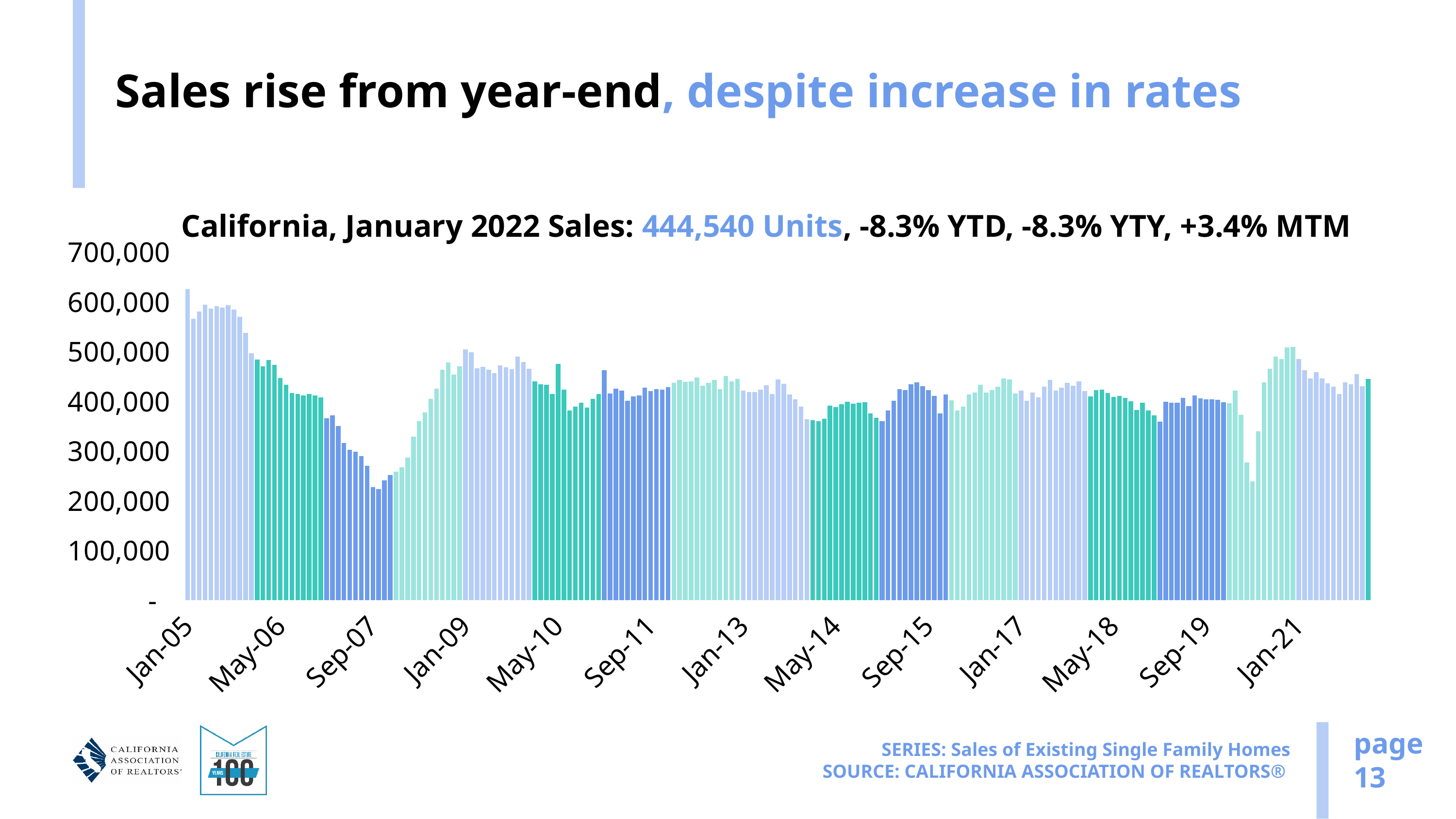
Is the value for Jan-05 greater or less than 600,000? greater Is the value for Sep-07 greater or less than 400,000? less According to the chart title, how many units were sold in California in January 2022? 444,540 Units Which of Jan-05 and Sep-07 has the larger value? Jan-05 What is the month-to-month (MTM) change in sales stated in the chart title? +3.4% What kind of chart is shown on the slide? bar chart What is the year-to-year (YTY) change in sales stated in the chart title? -8.3% Do the values rise or fall from Jan-05 to Sep-07? fall What series does the chart show, according to the footer? Sales of Existing Single Family Homes What is the first label on the x axis? Jan-05 Is the value for Jan-21 greater or less than 400,000? greater Which labeled month on the x axis has the highest bar? Jan-05